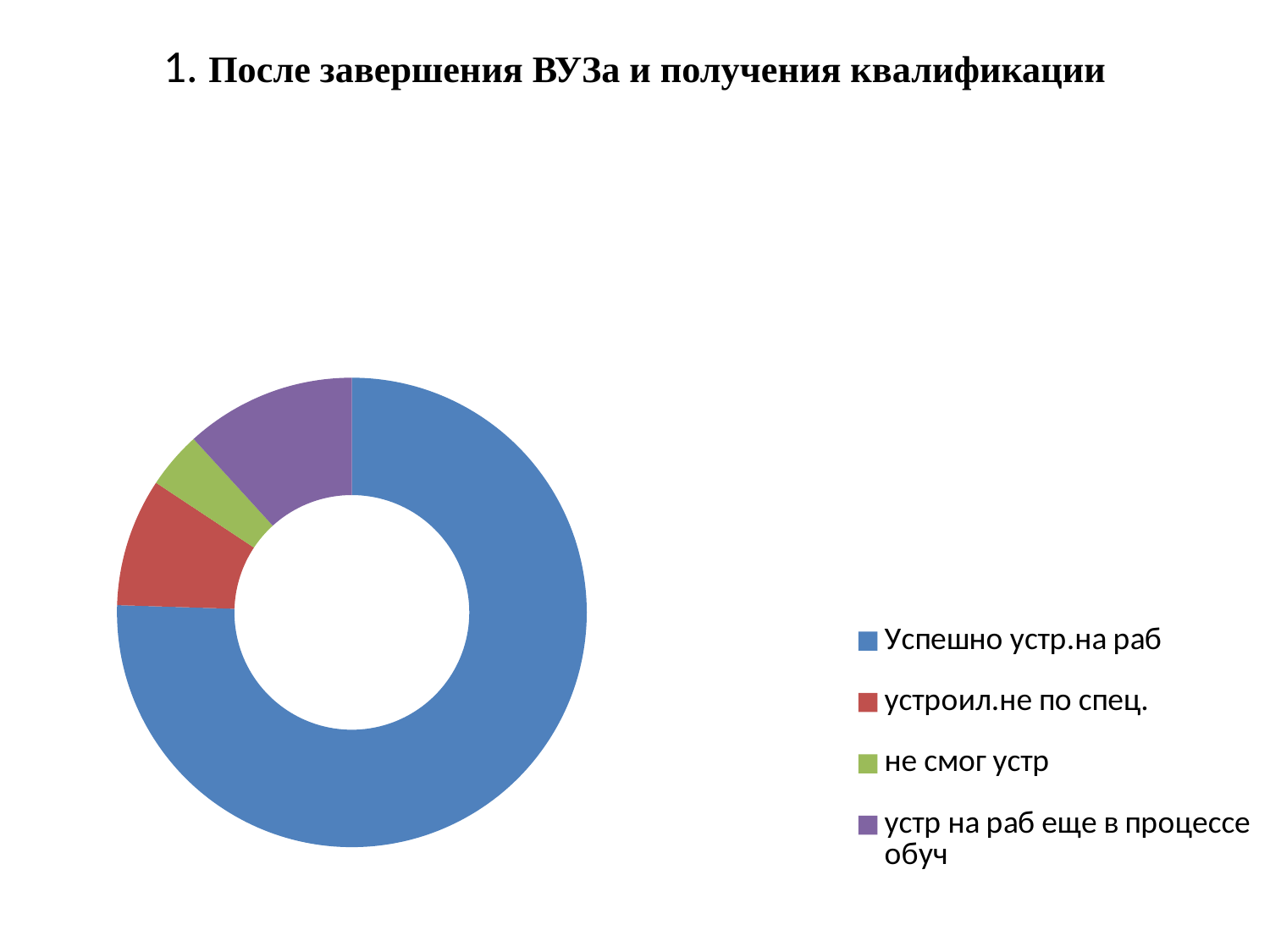
What colour represents "не смог устр" in the chart? green How many categories does the chart show? 4 Which category has the smallest share of the chart? не смог устр What kind of chart is shown on the slide? doughnut chart How many entries does the legend list? 4 What is the title of the slide above the chart? 1. После завершения ВУЗа и получения квалификации Which category has the largest share of the chart? Успешно устр.на раб Which is larger: the share for "Успешно устр.на раб" or the share for "устр на раб еще в процессе обуч"? Успешно устр.на раб Which is larger: the share for "устр на раб еще в процессе обуч" or the share for "не смог устр"? устр на раб еще в процессе обуч Which is larger: the share for "устроил.не по спец." or the share for "не смог устр"? устроил.не по спец.